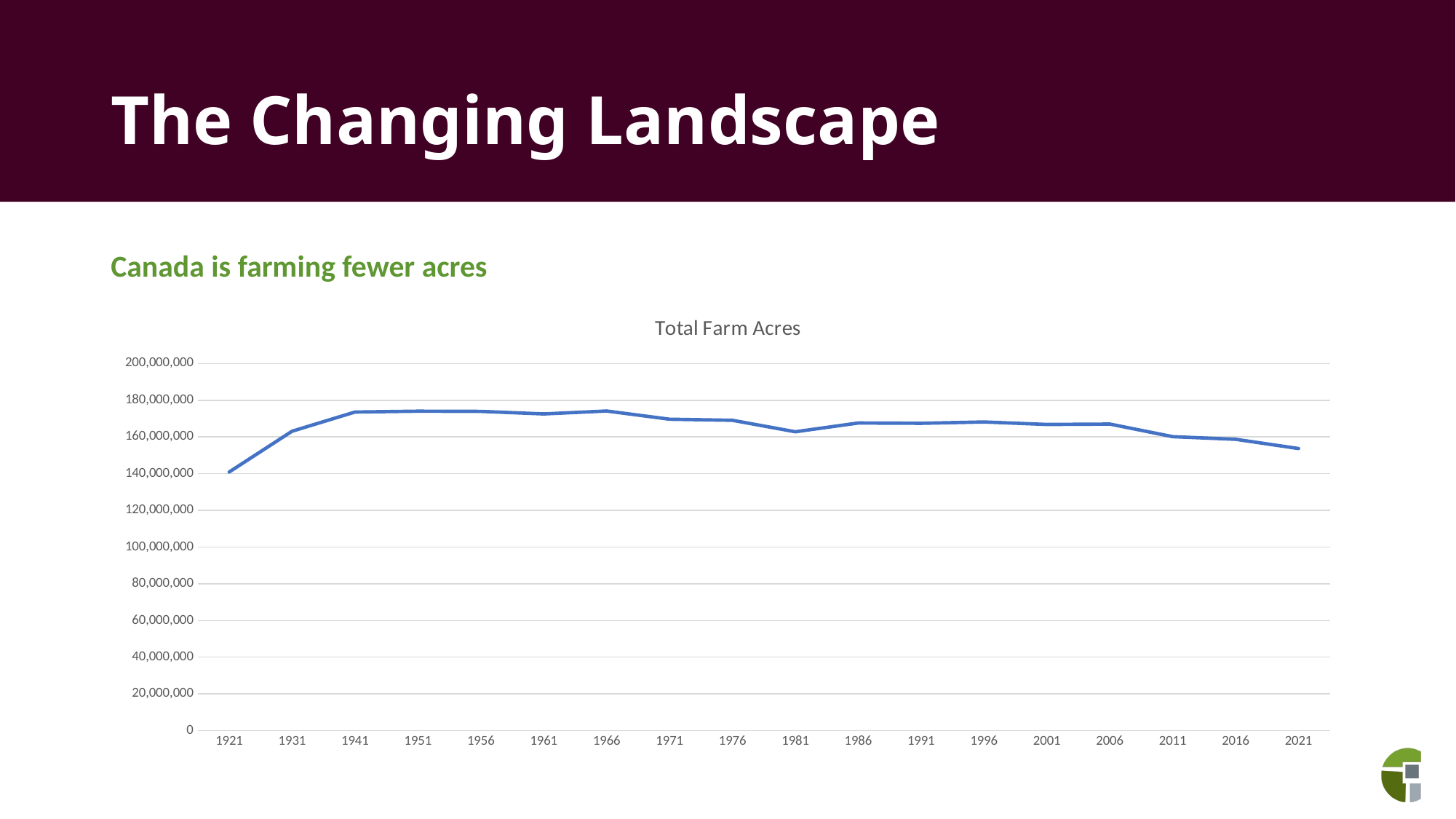
Do the values rise or fall from 1921 to 1941? rise Which year has the larger value, 1931 or 1941? 1941 What is the title of the chart? Total Farm Acres Is the value for 2021 greater or less than 160,000,000? less Is the value for 1921 greater or less than 160,000,000? less Do the values rise or fall from 2006 to 2021? fall Is the value for 1941 greater or less than 160,000,000? greater Which year has the larger value, 1921 or 2021? 2021 How many years are plotted along the x axis of the chart? 18 Which year has the lowest value for Total Farm Acres? 1921 What kind of chart is shown on the slide? Line chart